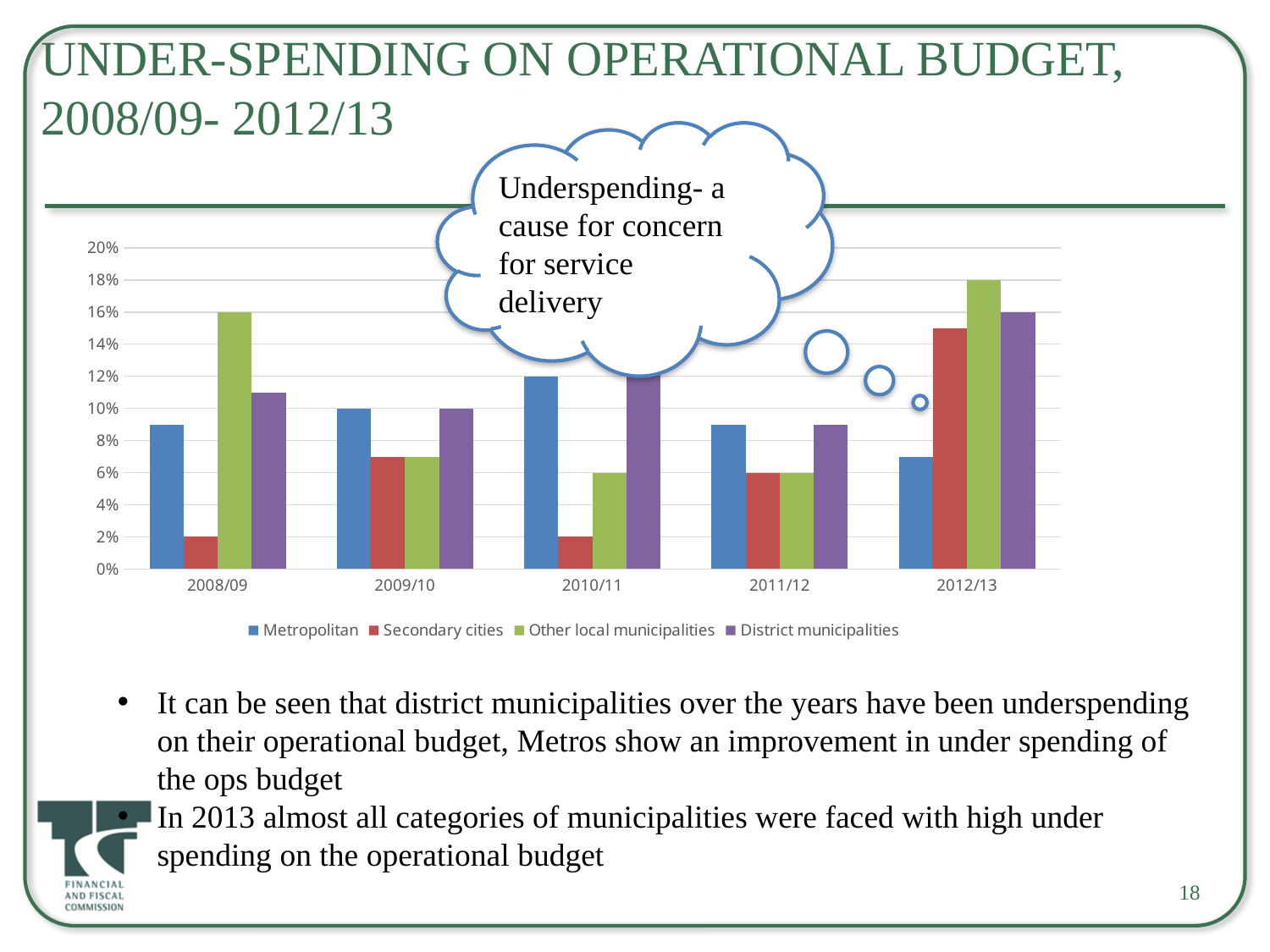
Which series has the lowest value in 2012/13? Metropolitan What kind of chart is shown on the slide? Bar chart What is the value for Other local municipalities in 2012/13? 18% What is the value for Other local municipalities in 2008/09? 16% Which series has the highest value in 2012/13? Other local municipalities How many financial years are shown on the x axis of the chart? 5 How many series does the chart legend list? 4 In 2012/13, which is larger: Secondary cities or Metropolitan? Secondary cities What is the value for Metropolitan in 2010/11? 12% Which series is shown in purple in the chart legend? District municipalities What is the value for Secondary cities in 2008/09? 2% Is the value for Metropolitan in 2012/13 greater or less than 8%? less